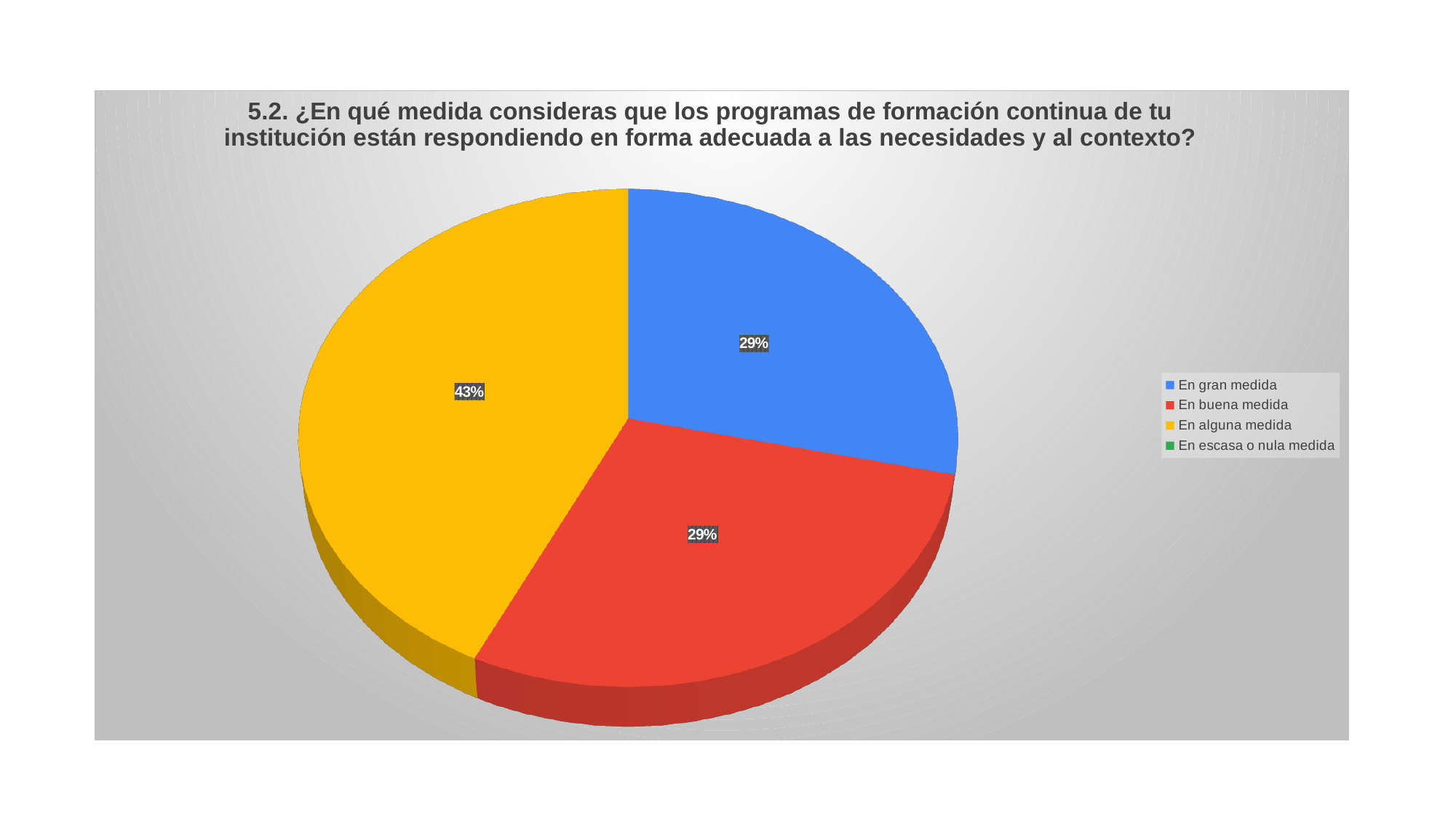
How many entries does the legend list? 4 What is the difference between the share for "En alguna medida" and the share for "En gran medida"? 14% What share of the pie does "En gran medida" represent? 29% What share of the pie does "En buena medida" represent? 29% Which legend entry has no visible slice in the pie? En escasa o nula medida What colour is the slice for "En buena medida"? red What kind of chart is shown on the slide? pie chart What share of the pie does "En alguna medida" represent? 43% Which is larger, the share for "En alguna medida" or the share for "En buena medida"? En alguna medida Which category has the largest slice of the pie? En alguna medida How many slices are visible in the pie? 3